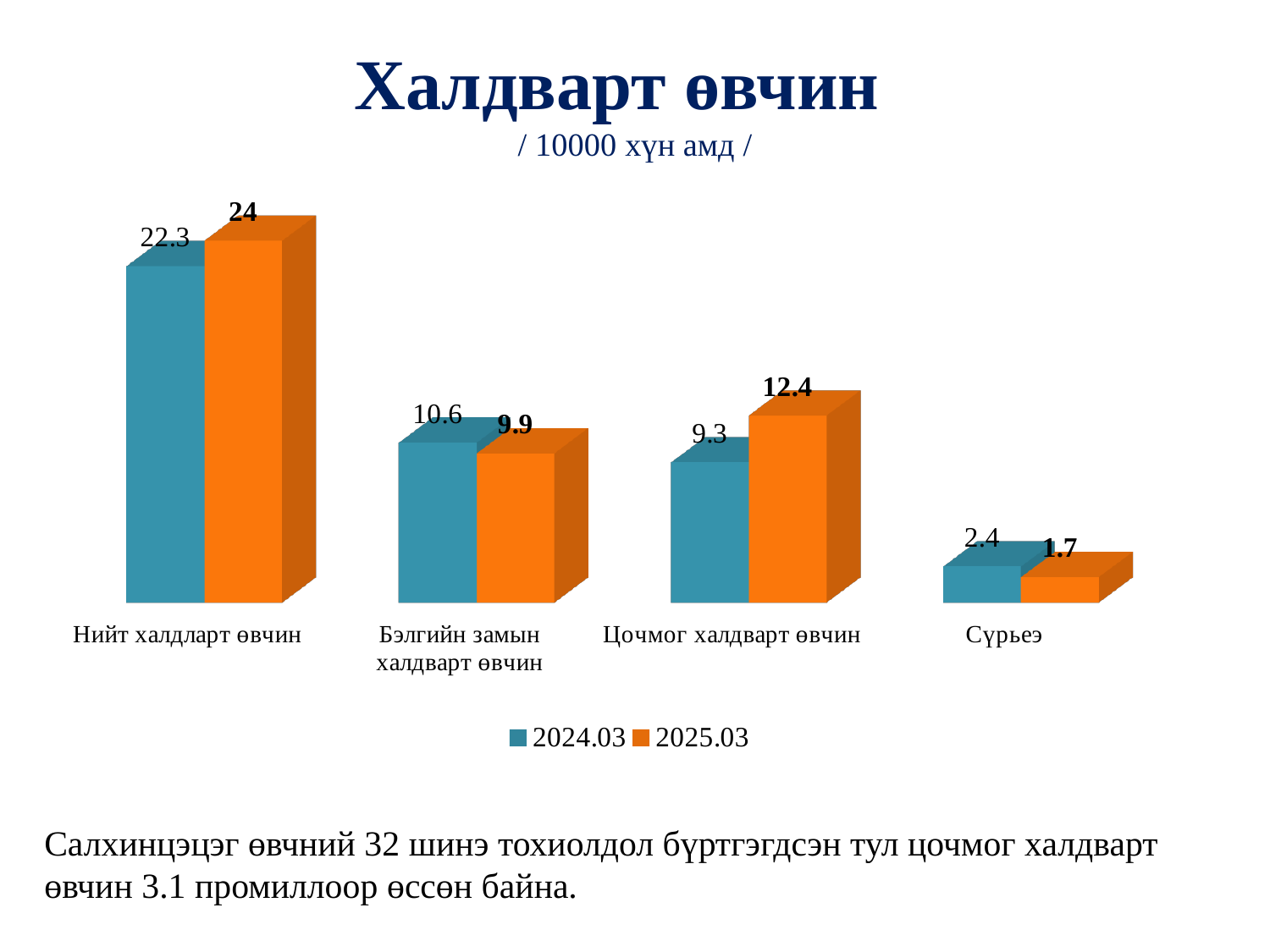
How many series does the legend list? 2 What is the value for Нийт халдларт өвчин in the 2025.03 series? 24 Which category has the lowest value in the 2025.03 series? Сүрьеэ What is the difference between the 2025.03 and 2024.03 values for Цочмог халдварт өвчин? 3.1 Which category has the highest value in the 2024.03 series? Нийт халдларт өвчин What is the title of the chart? Халдварт өвчин What is the value for Сүрьеэ in the 2025.03 series? 1.7 What kind of chart is shown on the slide? bar chart Which is larger for Нийт халдларт өвчин: the 2024.03 value or the 2025.03 value? 2025.03 What is the value for Цочмог халдварт өвчин in the 2024.03 series? 9.3 What is the difference between the 2024.03 and 2025.03 values for Бэлгийн замын халдварт өвчин? 0.7 How many categories are shown on the x axis? 4